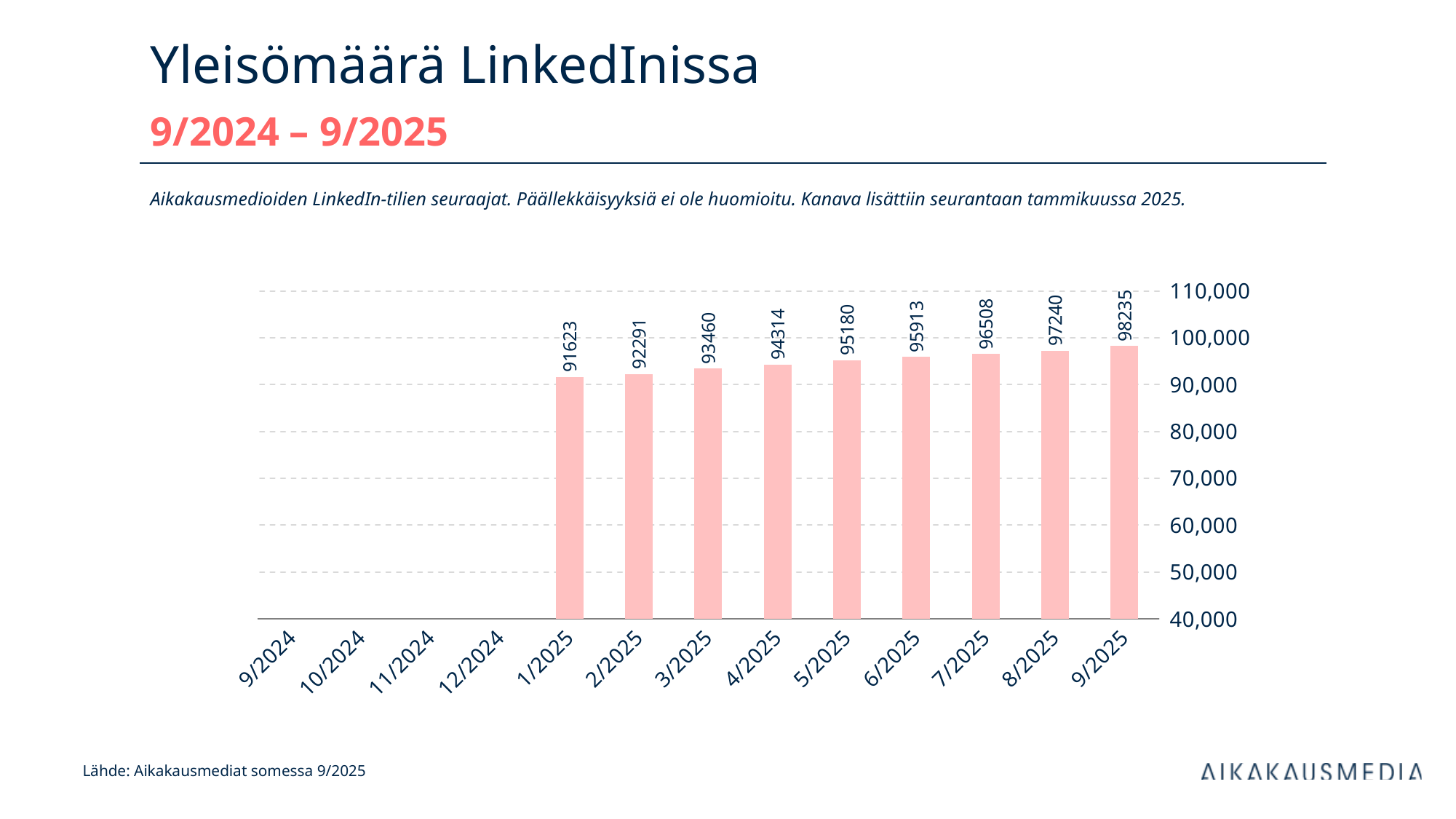
What is the difference between the values for 9/2025 and 1/2025? 6612 What is the value for 1/2025? 91623 Which is larger, the value for 7/2025 or the value for 4/2025? 7/2025 What is the value for 5/2025? 95180 Which month with a plotted bar has the lowest value? 1/2025 Do the values rise or fall from 1/2025 to 9/2025? rise Which month has the highest value? 9/2025 What is the value for 9/2025? 98235 Is the value for 6/2025 greater or less than 90,000? greater How many months have a plotted bar? 9 What is the difference between the values for 3/2025 and 2/2025? 1169 What kind of chart is shown? bar chart